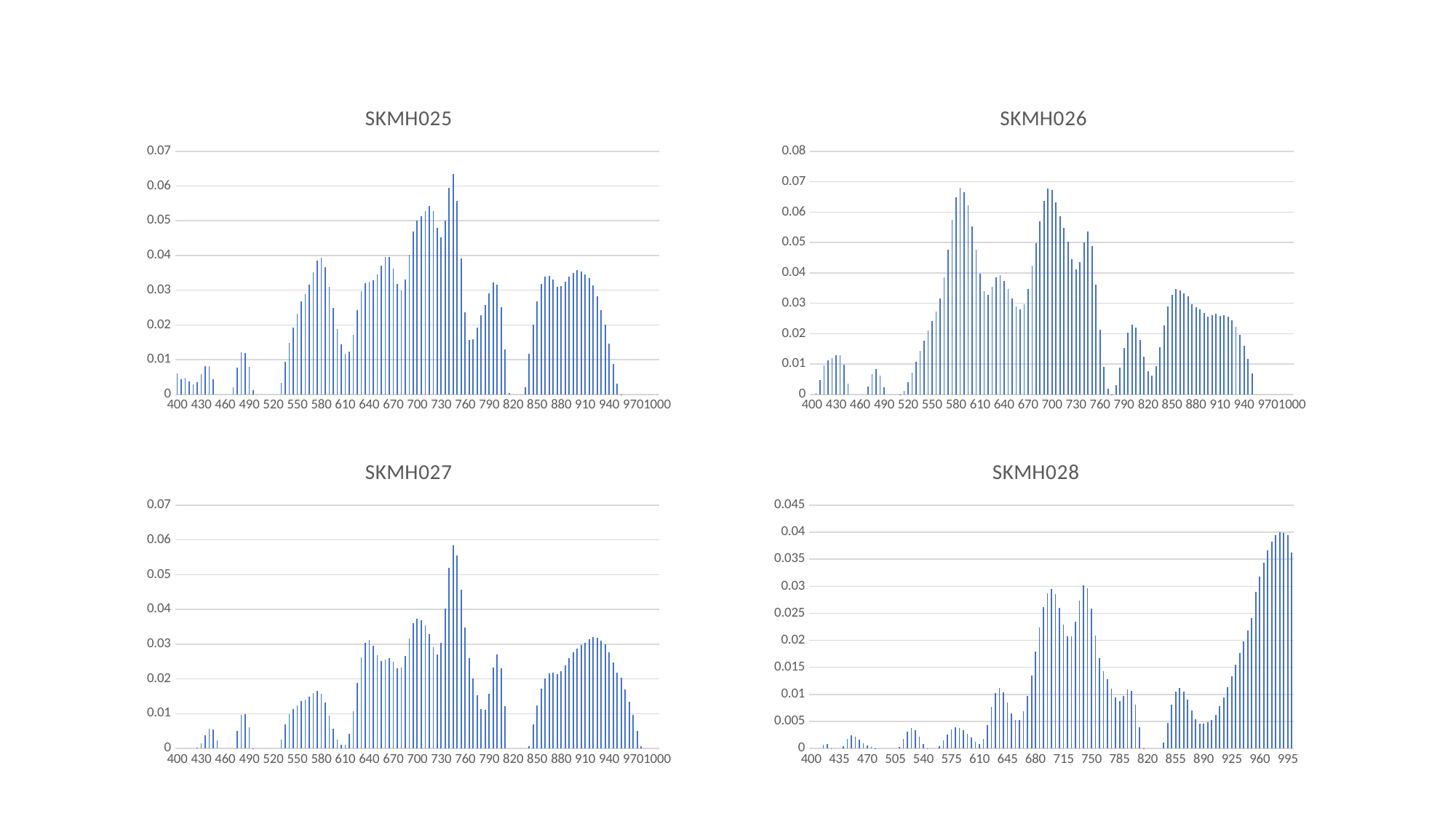
In the SKMH028 chart, do the bar values rise or fall along the x axis from 890 to 995? rise What is the title of the chart in the bottom-right position of the slide? SKMH028 In the SKMH028 chart, is the tallest bar greater or less than 0.035? greater In the SKMH025 chart, is the tallest bar greater or less than 0.06? greater What kind of chart is SKMH025? bar chart Which chart on the slide has the highest top value on its y axis? SKMH026 How many charts are shown on the slide? 4 In the SKMH028 chart, which is larger: the peak of bars near 995 or the peak of bars near 715? the peak near 995 What is the highest tick value shown on the y axis of the SKMH028 chart? 0.045 In the SKMH025 chart, do the bar values rise or fall along the x axis from 910 to 960? fall In the SKMH027 chart, is the tallest bar greater or less than 0.05? greater